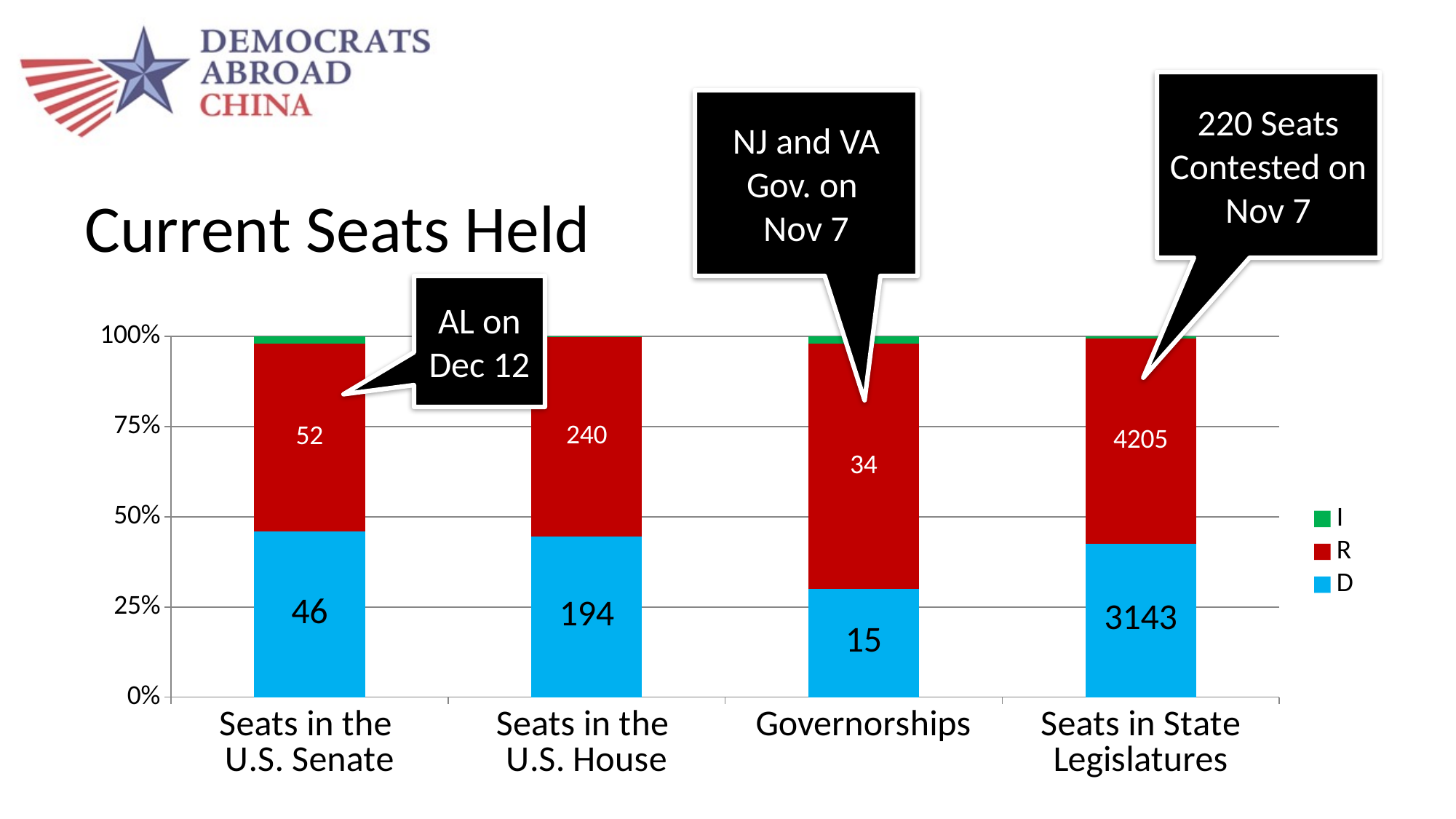
What is the difference between the R and D values in the Seats in State Legislatures bar? 1062 What is the value for R in the Seats in State Legislatures bar? 4205 In the Governorships bar, which is larger, the D value or the R value? R What is the value for R in the Governorships bar? 34 What is the value for D in the Seats in the U.S. Senate bar? 46 What is the title of the chart? Current Seats Held What is the value for R in the Seats in the U.S. House bar? 240 What is the value for D in the Governorships bar? 15 Is the D share of the Governorships bar greater or less than 50%? less How many series does the legend list? 3 What is the difference between the R and D values in the Seats in the U.S. House bar? 46 How many categories are shown on the x axis? 4